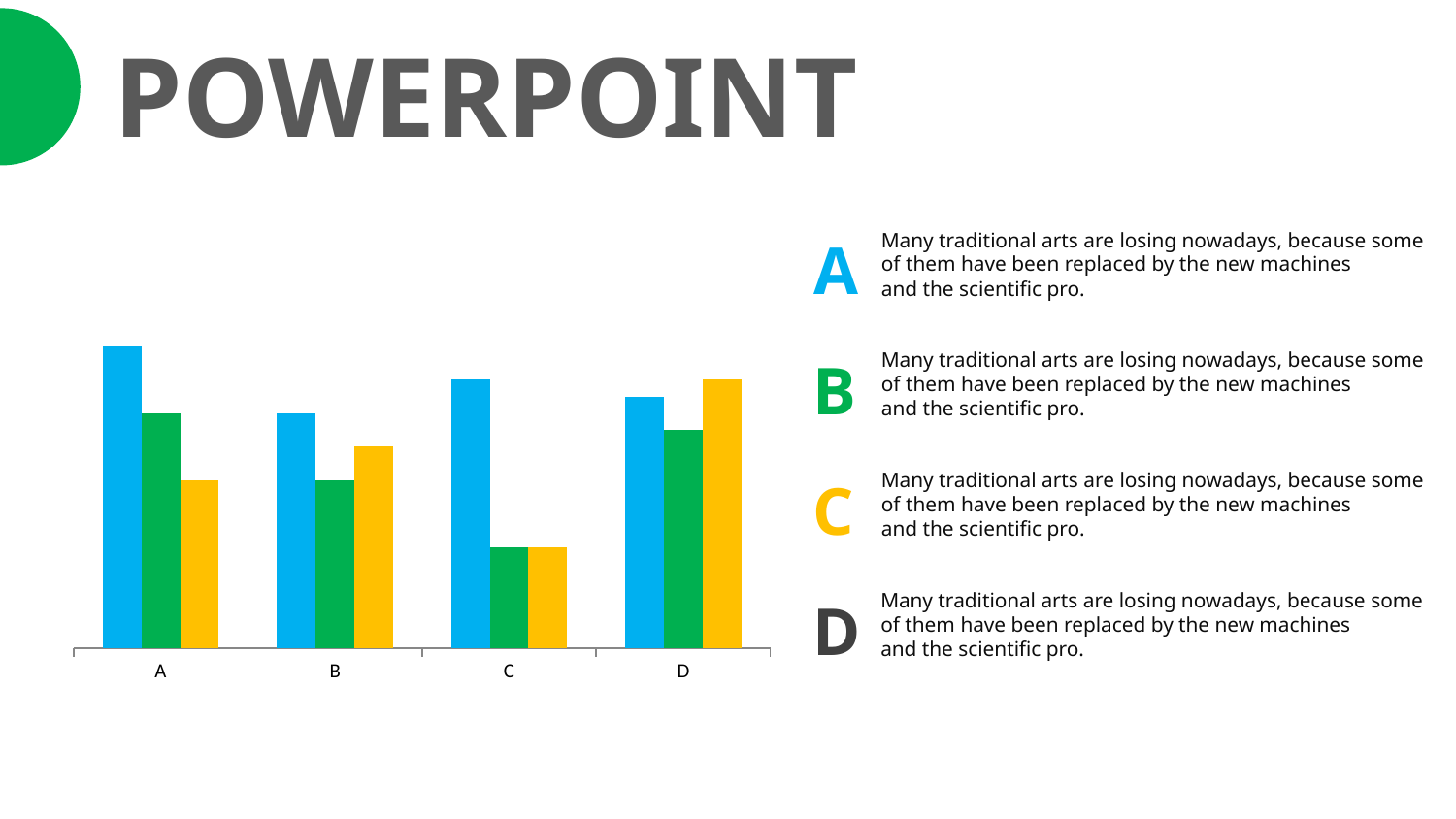
Which category has the tallest blue bar? A What kind of chart is shown on the slide? bar chart In category A, which coloured bar is the shortest? yellow Which category has the shortest green bar? C In category A, which coloured bar is the tallest? blue How many bars are plotted for each category in the chart? 3 How many categories are shown on the x axis of the chart? 4 Which category has the tallest yellow bar? D Which category has the shortest yellow bar? C Is the yellow bar for category B taller or shorter than the yellow bar for category A? taller Is the blue bar for category A taller or shorter than the blue bar for category C? taller